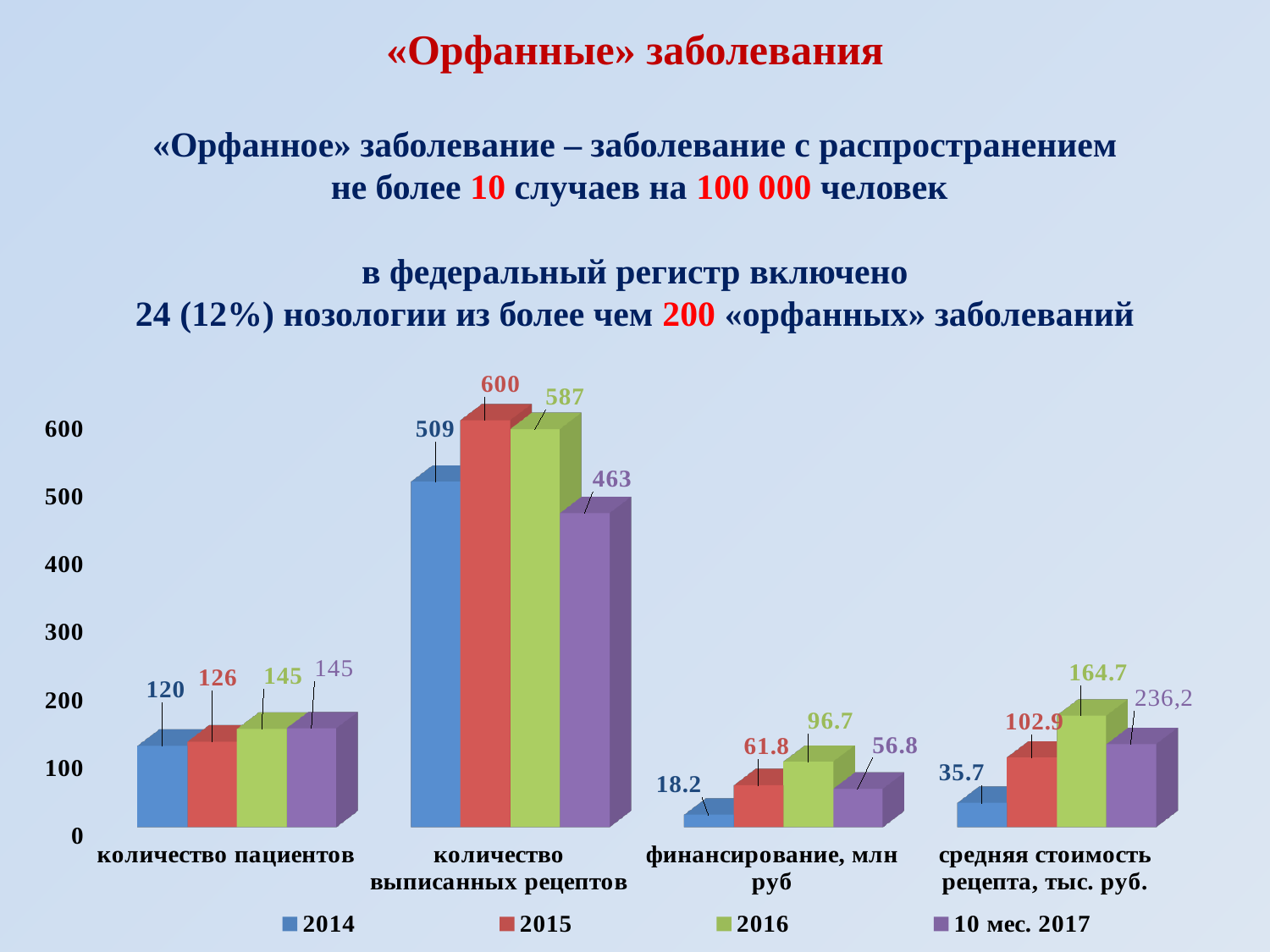
How many categories are shown on the x axis? 4 What is the value for 2016 in the category 'финансирование, млн руб'? 96.7 Which year has the lowest value in the category 'финансирование, млн руб'? 2014 What is the value for 2015 in the category 'средняя стоимость рецепта, тыс. руб.'? 102.9 What is the value for 2014 in the category 'количество пациентов'? 120 Which is larger in the category 'количество выписанных рецептов': the value for 2016 or for 10 мес. 2017? 2016 How many series does the legend list? 4 Which year has the highest value in the category 'количество выписанных рецептов'? 2015 What type of chart is shown on the slide? bar chart Is the value for 2014 in the category 'количество выписанных рецептов' greater or less than 500? greater What is the value for 2015 in the category 'количество выписанных рецептов'? 600 What is the difference between the 2015 and 2014 values in the category 'количество пациентов'? 6